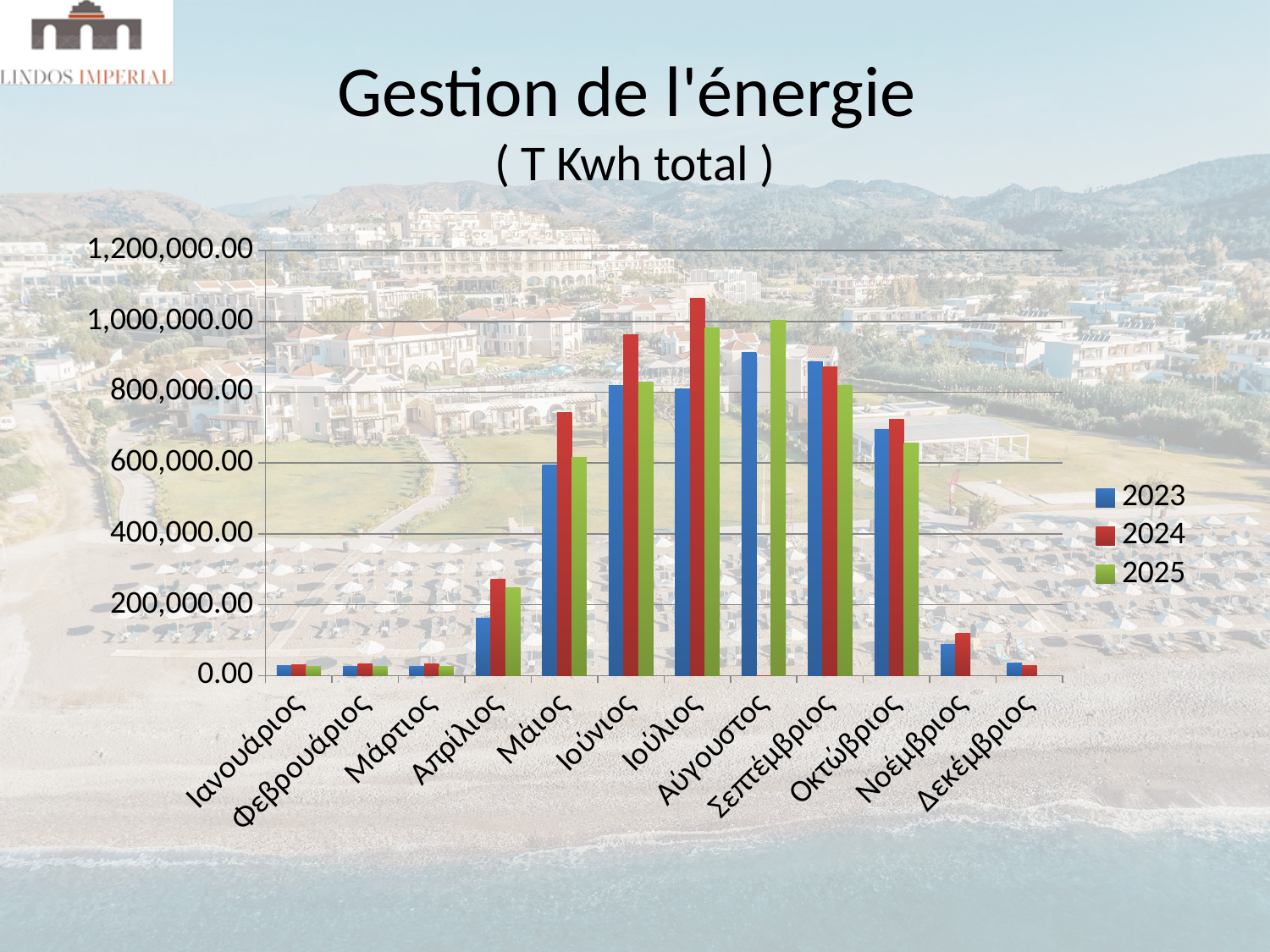
Which is larger for Μάιος, the 2024 value or the 2025 value? 2024 What kind of chart is shown on the slide? Bar chart How many series does the legend list? 3 Which is larger for Ιούλιος, the 2023 value or the 2024 value? 2024 Is the 2023 value for Απρίλιος greater or less than 200,000.00? less Do the 2023 values rise or fall from Σεπτέμβριος to Δεκέμβριος? fall Is the 2024 value for Ιούλιος greater or less than 1,000,000.00? greater Which month has the highest value for the 2024 series? Ιούλιος How many months are shown along the x axis? 12 What is the title of the chart on the slide? Gestion de l'énergie ( T Kwh total ) Is the 2024 value for Ιούνιος greater or less than 800,000.00? greater